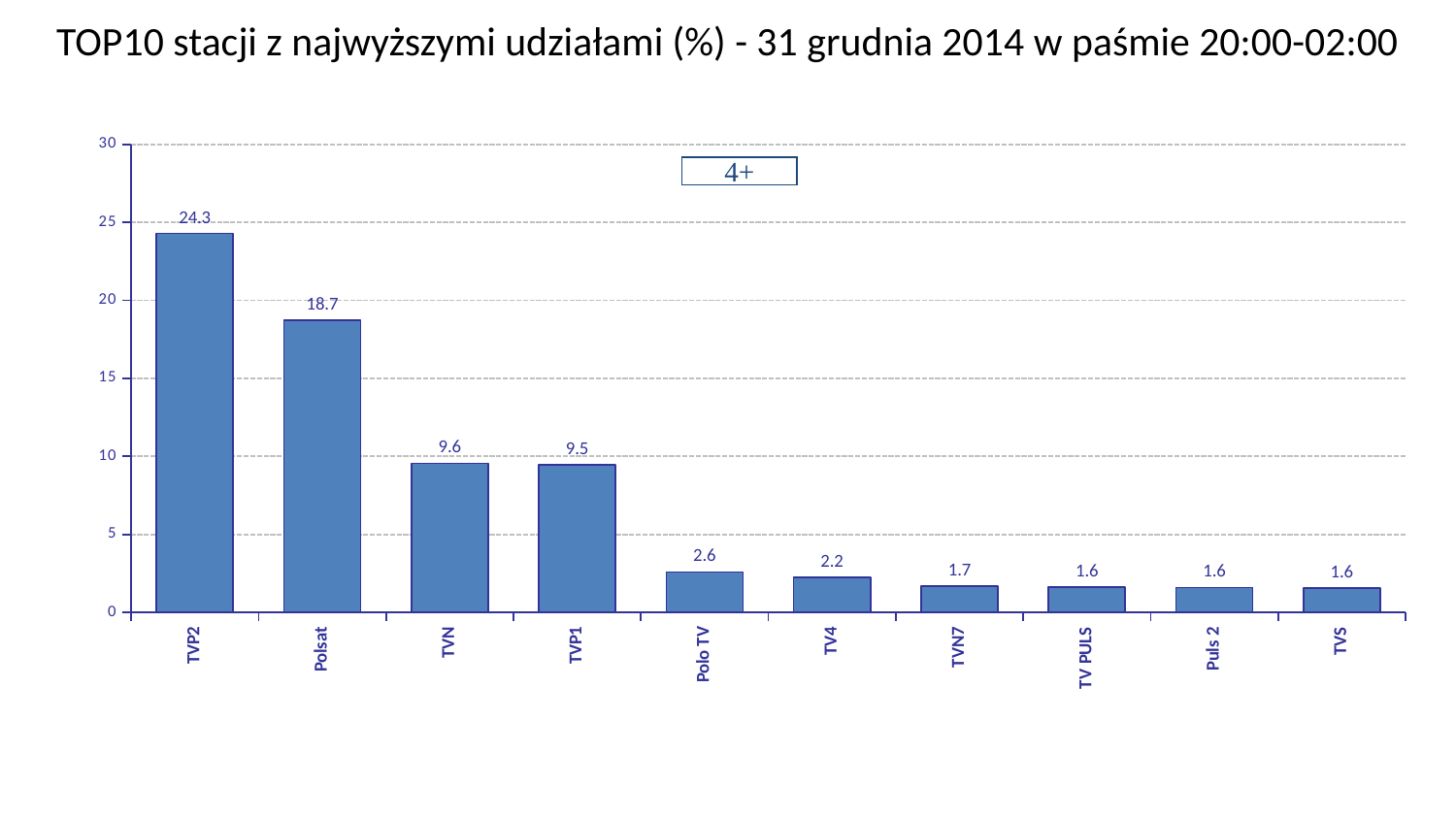
What label appears in the box above the chart? 4+ How many stations are shown on the chart? 10 What is the value for Polo TV? 2.6 What is the difference between the values for TVN and TVP1? 0.1 Which is larger, the value for Polo TV or the value for TV4? Polo TV What kind of chart is shown on the slide? bar chart Which station has the highest value? TVP2 Do the values rise or fall from left to right along the x axis? fall What is the difference between the values for TVP2 and Polsat? 5.6 Is the value for TVN greater or less than 5? greater What is the value for Polsat? 18.7 What is the value for TVP2? 24.3